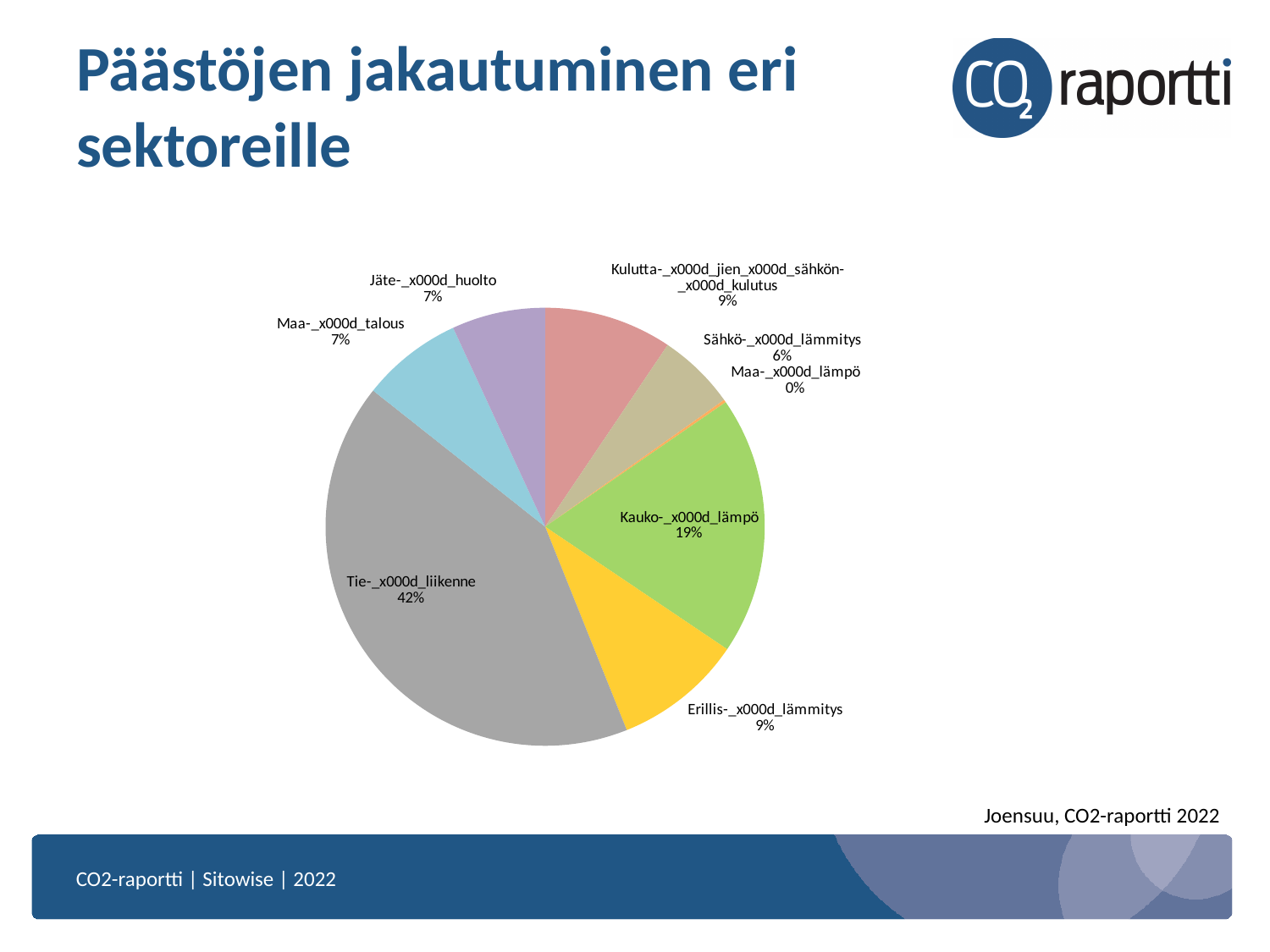
What kind of chart is shown on the slide? pie chart How many slices does the pie chart have? 8 What percentage is shown for Erillislämmitys? 9% What is the difference in percentage points between Tieliikenne and Kaukolämpö? 23 percentage points Which has a larger share, Kaukolämpö or Erillislämmitys? Kaukolämpö What share of emissions does Kaukolämpö account for? 19% Which sector has the smallest share of emissions in the pie chart? Maalämpö (0%) What is the combined share of Jätehuolto and Maatalous? 14% What is the title of the slide containing the pie chart? Päästöjen jakautuminen eri sektoreille What percentage is shown for Sähkölämmitys? 6% Which sector has the largest share of emissions in the pie chart? Tieliikenne (42%) What percentage is shown for Kuluttajien sähkönkulutus? 9%